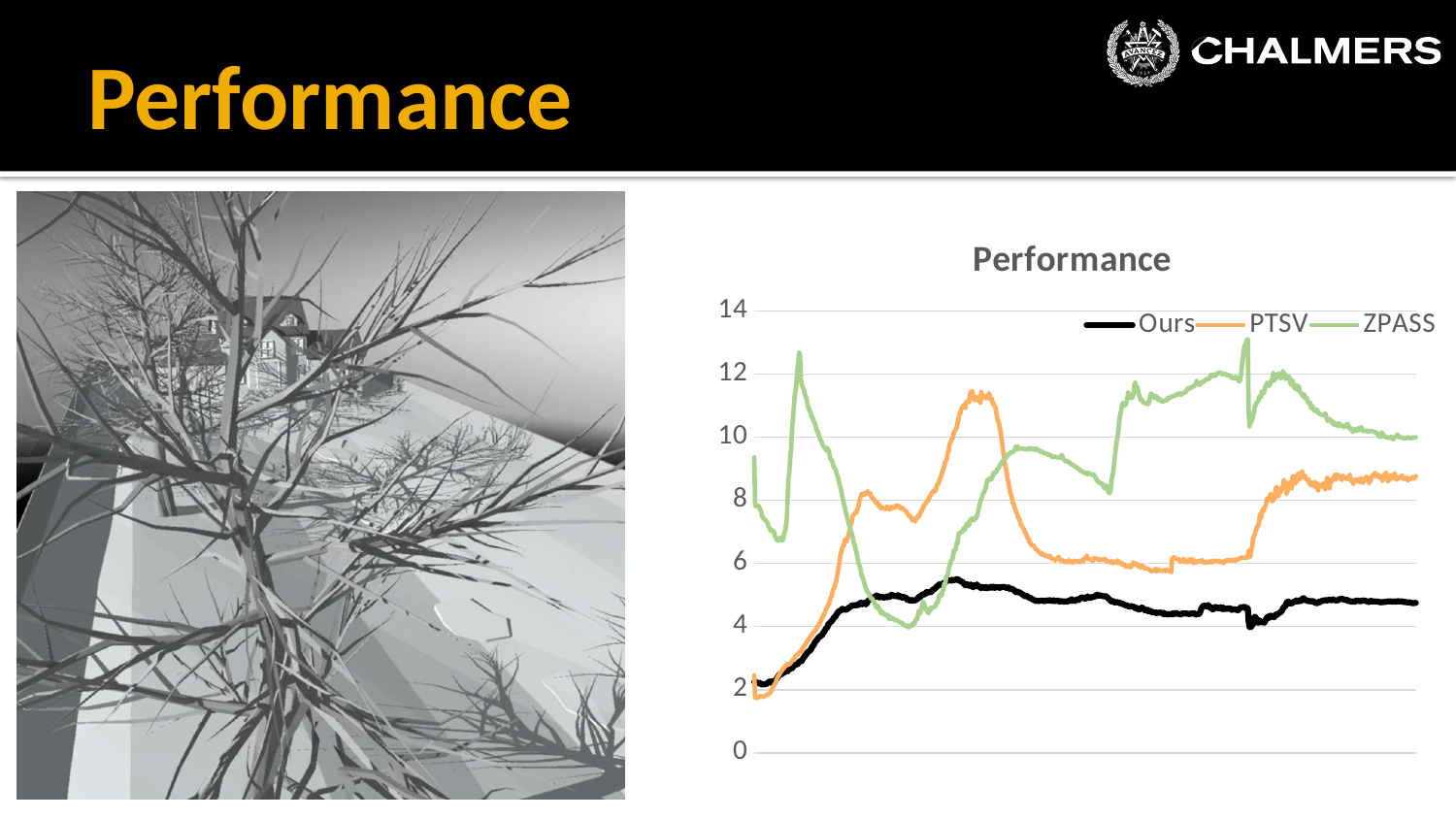
What is the highest value shown on the y axis of the Performance chart? 14 What kind of chart is shown on the slide? line chart At the right end of the Performance chart, which series is higher, PTSV or Ours? PTSV At the right end of the Performance chart, which series is higher, ZPASS or PTSV? ZPASS Is the value of the ZPASS series at the right end of the chart greater or less than 8? greater What is the title of the chart on the slide? Performance Which series are listed in the legend of the Performance chart? Ours, PTSV, ZPASS Does the Ours series ever rise above 6 on the Performance chart? No Which series has the lowest value at the right end of the Performance chart? Ours How many series does the legend of the Performance chart list? 3 Is the value of the Ours series at the right end of the chart greater or less than 6? less Which series reaches the highest value anywhere on the Performance chart? ZPASS